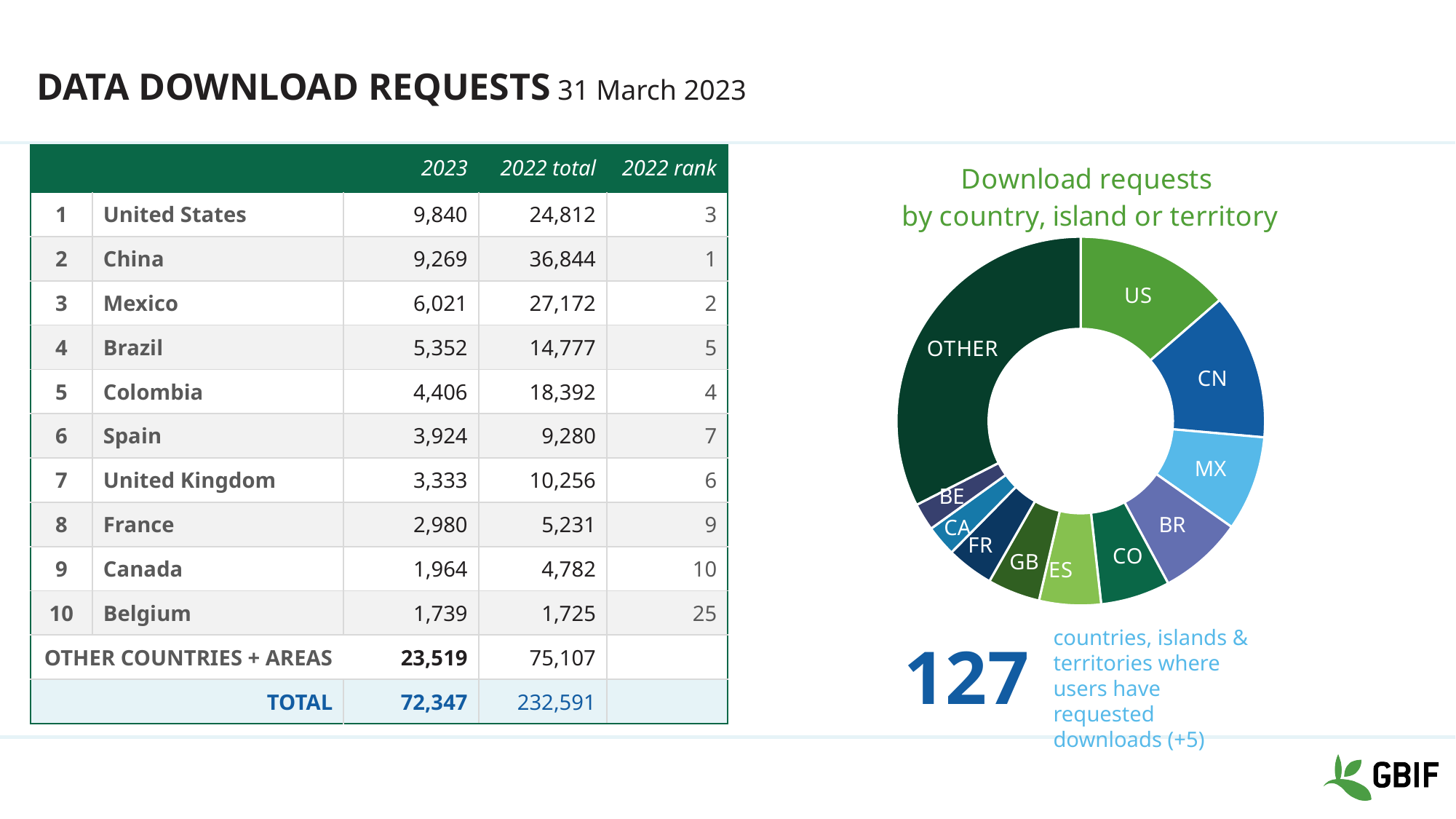
Excluding the OTHER slice, which country has the largest slice in the donut chart? US What kind of chart is shown on the right of the slide? Donut (pie) chart Using the table values, what is the difference in 2023 download requests between the MX and BR slices? 669 According to the table, how many 2023 download requests does the OTHER slice of the donut chart represent? 23,519 In the donut chart, which slice is larger, MX or BR? MX Which slice of the donut chart is the largest? OTHER How many countries, islands and territories does the slide say users have requested downloads from? 127 According to the table, how many 2023 download requests does the US slice of the donut chart represent? 9,840 What is the title of the donut chart? Download requests by country, island or territory In the donut chart, which slice is larger, CO or CA? CO Which slice of the donut chart is the smallest? BE How many slices does the donut chart have? 11